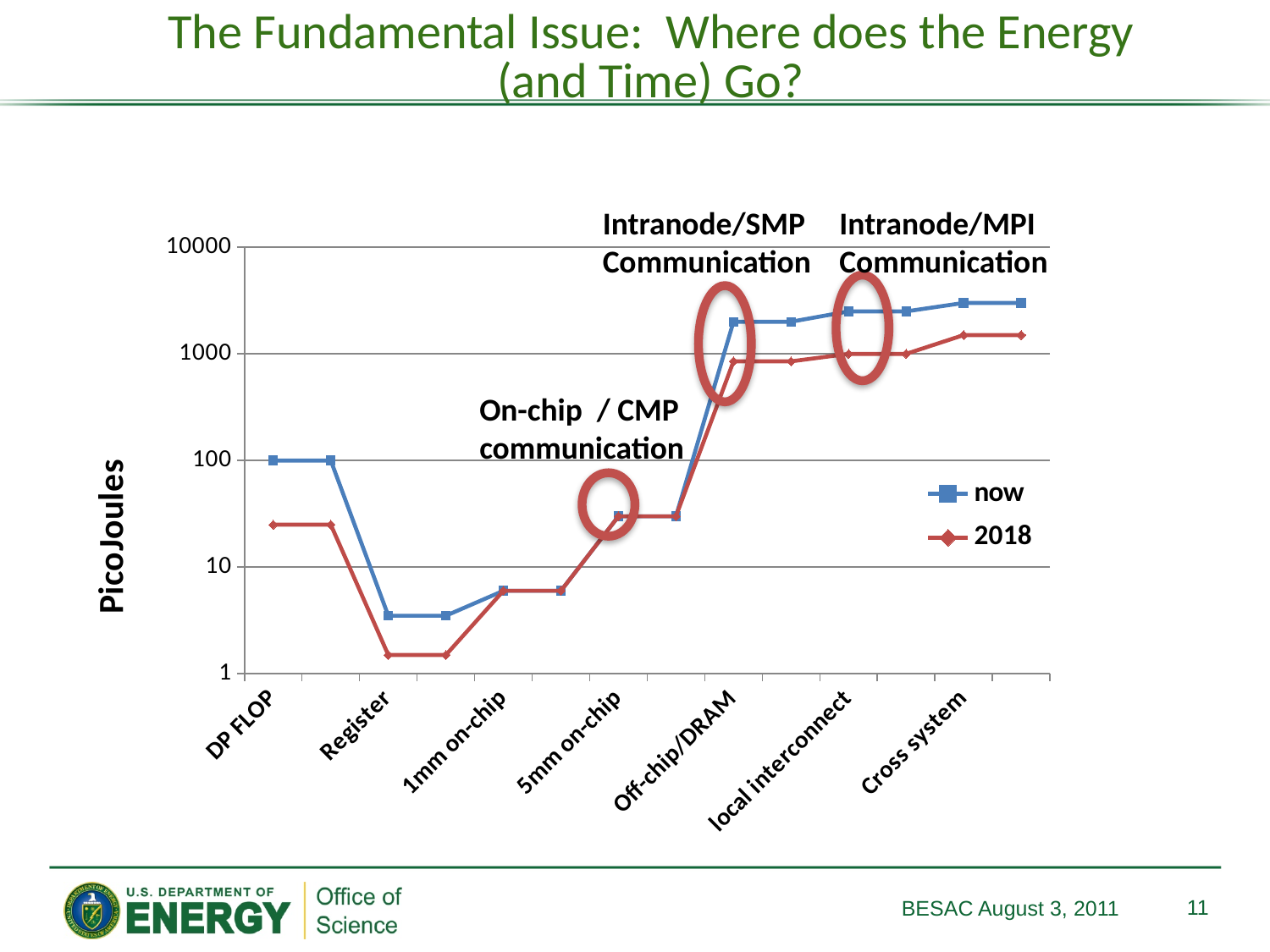
What are the two series named in the legend? now and 2018 Is the value of the 'now' series for Register greater or less than 10? less Is the value of the 'now' series for Off-chip/DRAM greater or less than 1000? greater Does the 'now' series rise or fall from 5mm on-chip to Off-chip/DRAM? rise What is the value of the 'now' series for DP FLOP? 100 Is the value of the 'now' series for 5mm on-chip greater or less than 100? less What is the label on the vertical axis? PicoJoules For Cross system, which series has the larger value, 'now' or '2018'? now How many series does the legend list? 2 What kind of chart is shown on the slide? line chart